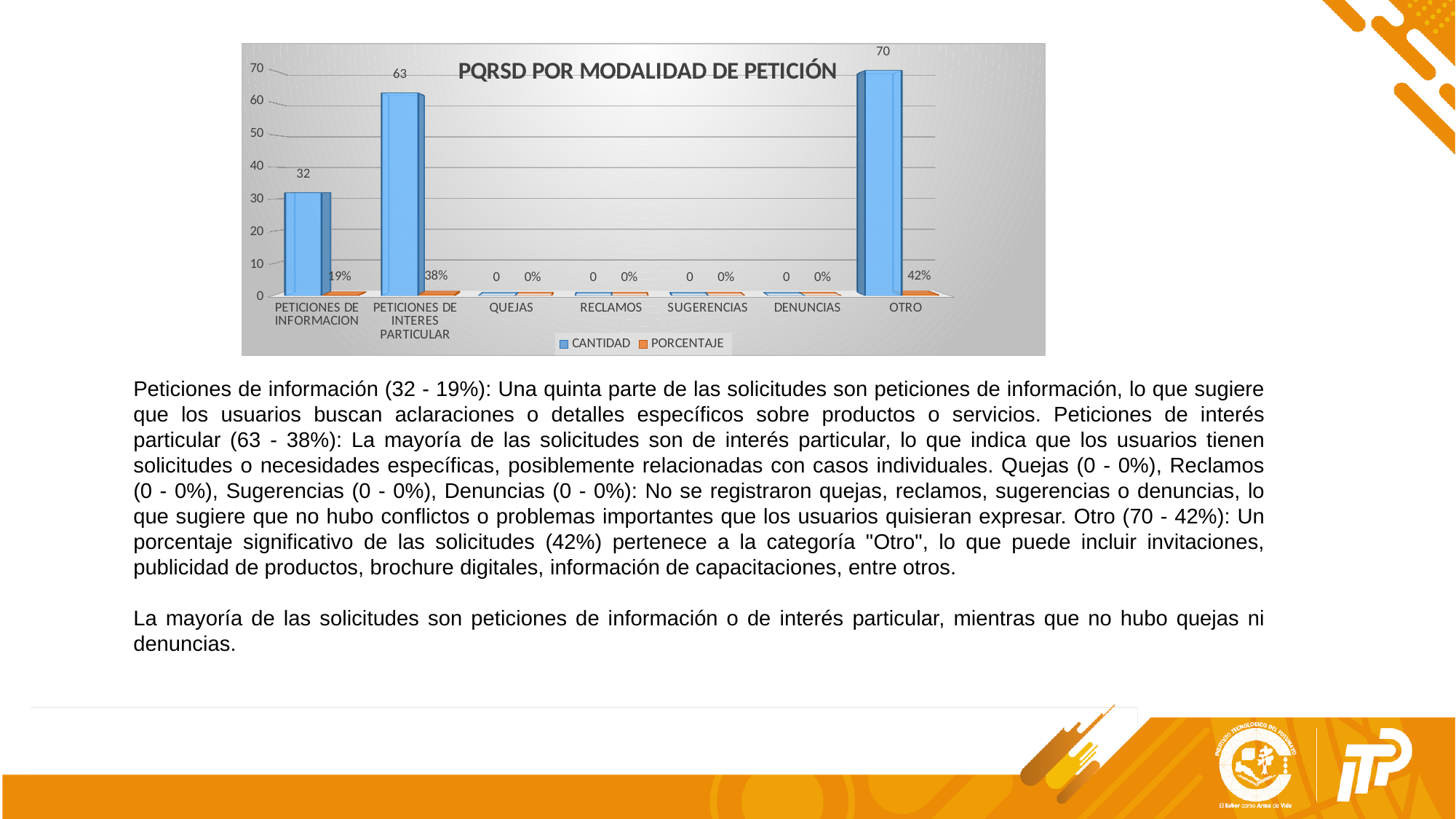
How many series does the legend list? 2 What is the PORCENTAJE value for OTRO? 42% What is the difference in CANTIDAD between OTRO and PETICIONES DE INFORMACION? 38 What kind of chart is shown on the slide? Bar chart How many categories are shown on the x axis? 7 Which has a larger CANTIDAD value, PETICIONES DE INFORMACION or PETICIONES DE INTERES PARTICULAR? PETICIONES DE INTERES PARTICULAR What is the PORCENTAJE value for PETICIONES DE INFORMACION? 19% What is the CANTIDAD value for QUEJAS? 0 What is the CANTIDAD value for OTRO? 70 What is the title of the chart? PQRSD POR MODALIDAD DE PETICIÓN Which category has the highest CANTIDAD value? OTRO What is the CANTIDAD value for PETICIONES DE INTERES PARTICULAR? 63